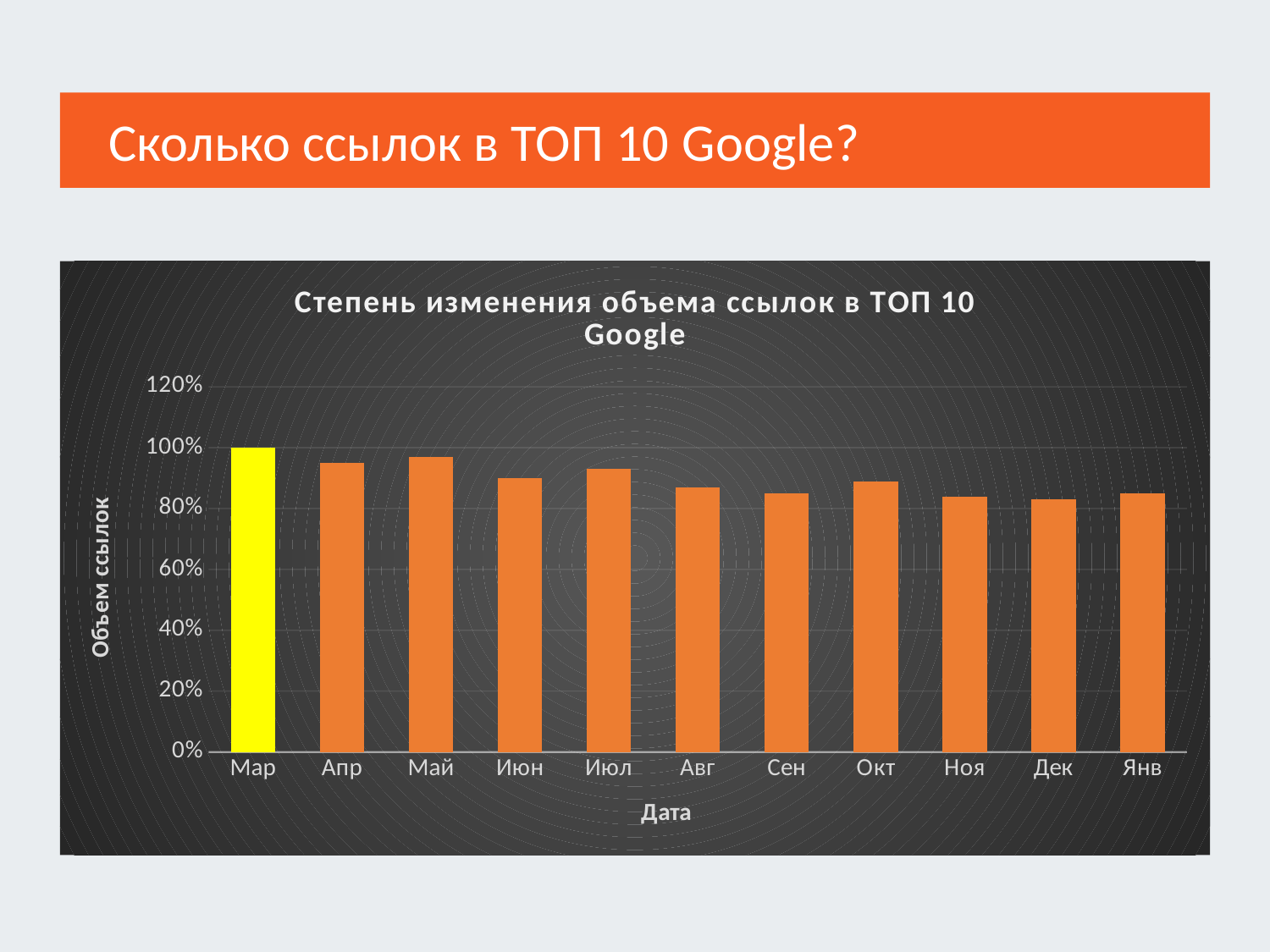
What is the value for Мар? 100% Which is larger, the value for Май or the value for Авг? Май Which is larger, the value for Апр or the value for Дек? Апр Which month has the highest value? Мар What colour is the bar for Мар? Yellow Is the value for Дек greater or less than 60%? greater How many months (categories) are plotted on the x axis? 11 What type of chart is shown on the slide? Bar chart Is the value for Июн greater or less than 100%? less What is the title of the chart? Степень изменения объема ссылок в ТОП 10 Google Is the value for Апр greater or less than 80%? greater Do the values generally rise or fall from Мар to Янв? fall